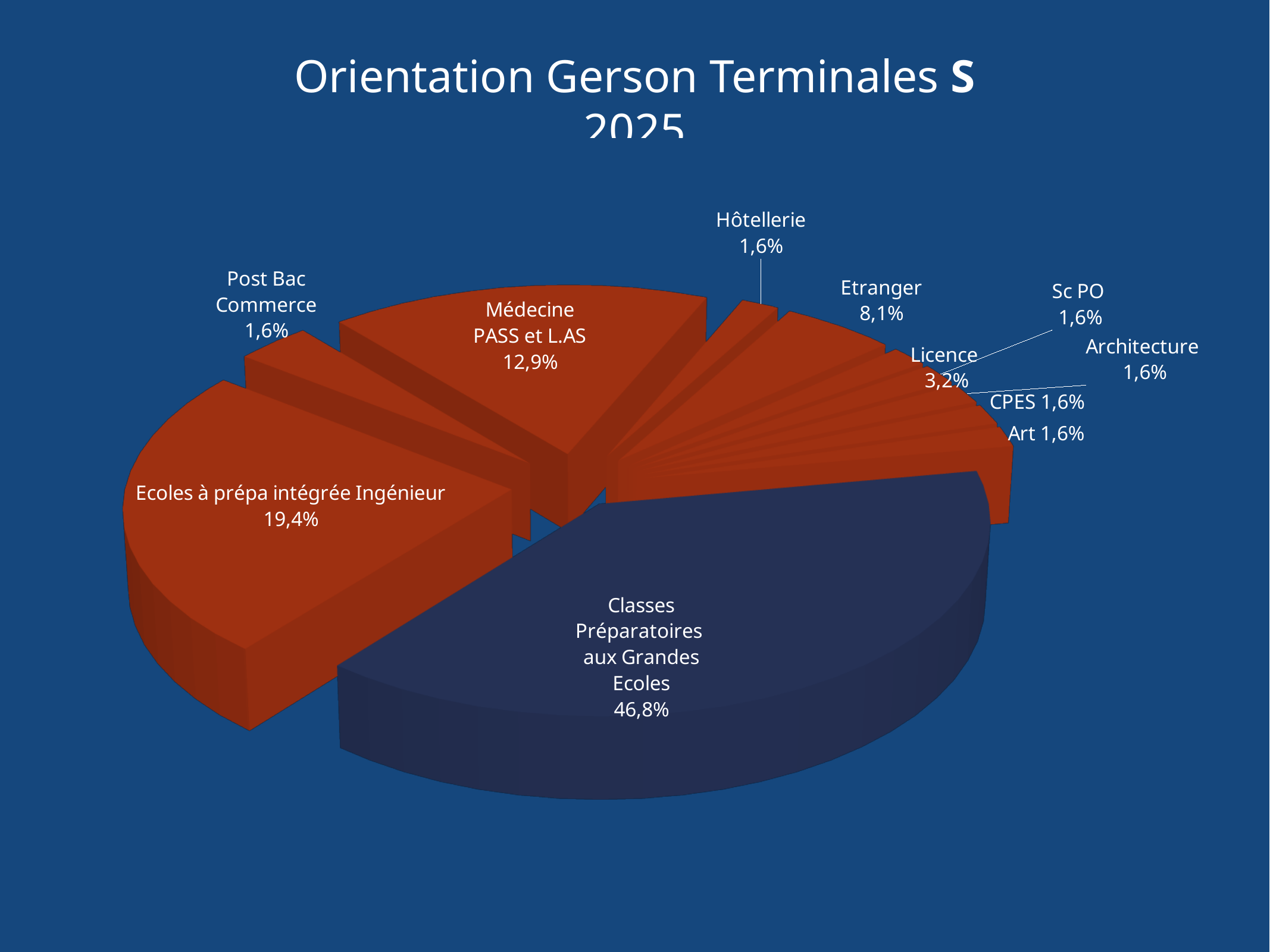
What is the difference between the values for Ecoles à prépa intégrée Ingénieur and Médecine PASS et L.AS? 6,5% What is the title of the chart? Orientation Gerson Terminales S 2025 How many categories are shown in the pie chart? 11 What is the value shown for Médecine PASS et L.AS? 12,9% What kind of chart is shown on the slide? Pie chart What is the value shown for Hôtellerie? 1,6% Which category has the largest slice of the pie? Classes Préparatoires aux Grandes Ecoles What is the value shown for Etranger? 8,1% What share of the pie does Classes Préparatoires aux Grandes Ecoles represent? 46,8% What is the value shown for Ecoles à prépa intégrée Ingénieur? 19,4% What is the value shown for Licence? 3,2% Which is larger, the value for Etranger or the value for Licence? Etranger